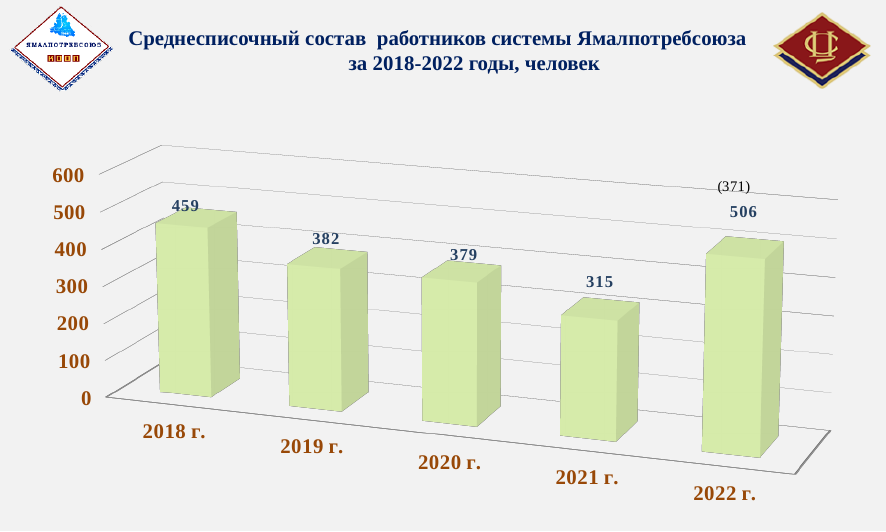
How many years are shown on the chart? 5 Which is larger, the value for 2018 г. or the value for 2020 г.? 2018 г. What is the value for 2022 г.? 506 What kind of chart is shown on the slide? bar chart Which year has the lowest value? 2021 г. What is the value for 2018 г.? 459 What is the difference between the values for 2022 г. and 2021 г.? 191 Which year has the highest value? 2022 г. What number is shown in parentheses above the 2022 г. bar? (371) What is the value for 2021 г.? 315 Is the value for 2021 г. greater or less than 400? less What is the difference between the values for 2018 г. and 2019 г.? 77